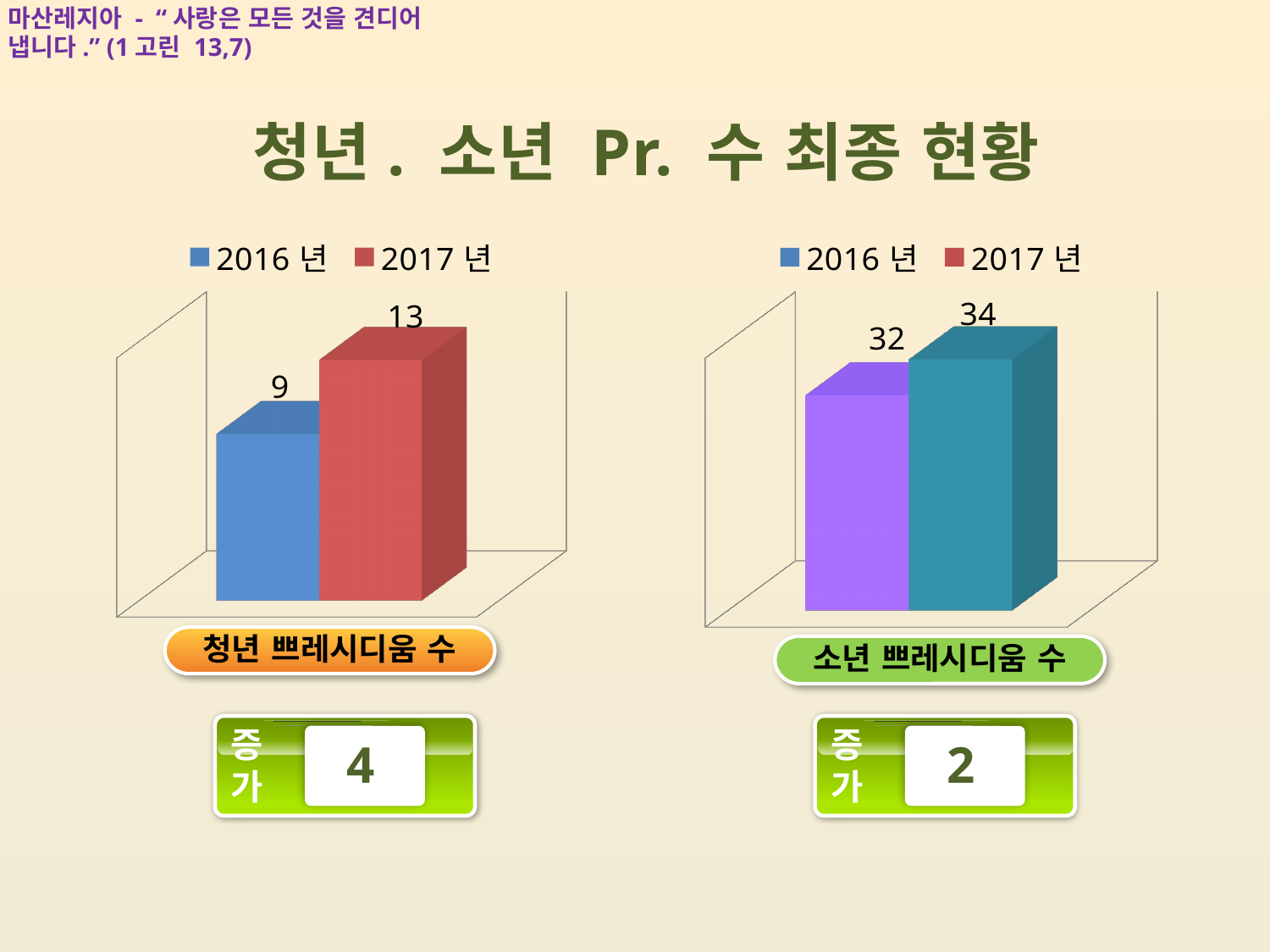
How many series does the legend of the left chart (청년 쁘레시디움 수) list? 2 In the right chart (소년 쁘레시디움 수), what is the value for 2017 년? 34 In the left chart (청년 쁘레시디움 수), which year has the higher value? 2017 년 In the right chart (소년 쁘레시디움 수), is the value for 2017 년 larger or smaller than the value for 2016 년? larger In the left chart (청년 쁘레시디움 수), what is the value for 2016 년? 9 In the right chart (소년 쁘레시디움 수), which year has the lower value? 2016 년 In the right chart (소년 쁘레시디움 수), what is the difference between the 2017 년 and 2016 년 values? 2 In the left chart (청년 쁘레시디움 수), what is the difference between the 2017 년 and 2016 년 values? 4 In the right chart (소년 쁘레시디움 수), what is the value for 2016 년? 32 In the left chart (청년 쁘레시디움 수), what is the value for 2017 년? 13 What are the two legend entries shown above the left chart (청년 쁘레시디움 수)? 2016 년 and 2017 년 What kind of chart is the right chart (소년 쁘레시디움 수)? bar chart